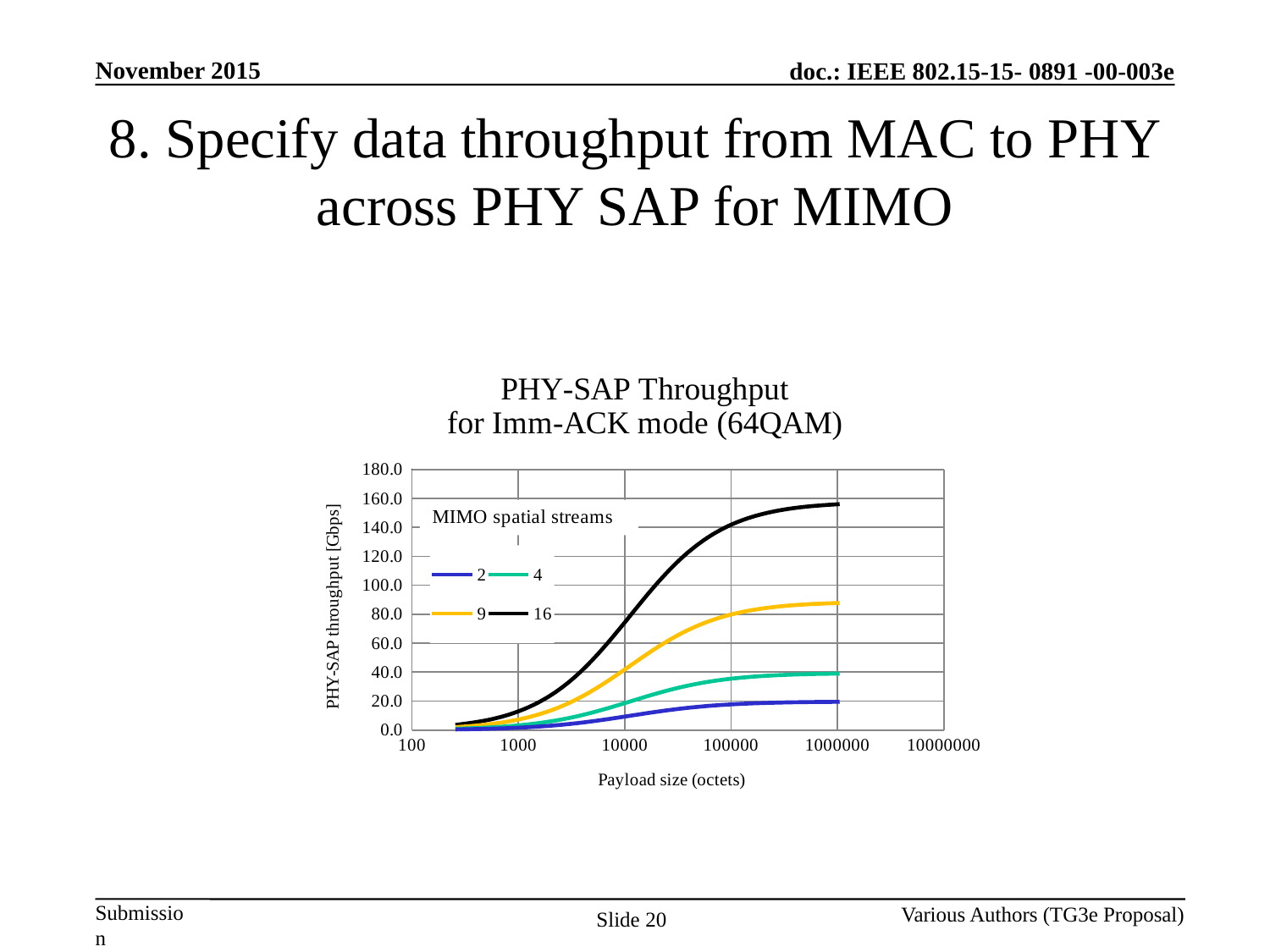
Does the throughput of the 16-stream series rise or fall as payload size increases along the x axis? rise Is the value for the 16-stream series at 1000000 octets greater or less than 140? greater What is the title of the chart? PHY-SAP Throughput for Imm-ACK mode (64QAM) What heading appears above the legend entries in the chart? MIMO spatial streams How many series does the legend list? 4 Which series has the lowest PHY-SAP throughput at a payload size of 1000000 octets? 2 At a payload size of 100000 octets, which series has the larger throughput, 16 streams or 9 streams? 16 Is the value for the 16-stream series at 10000 octets greater or less than 60? greater What kind of chart is shown on the slide? line chart Is the value for the 9-stream series at 1000000 octets greater or less than 80? greater Which series has the highest PHY-SAP throughput at a payload size of 1000000 octets? 16